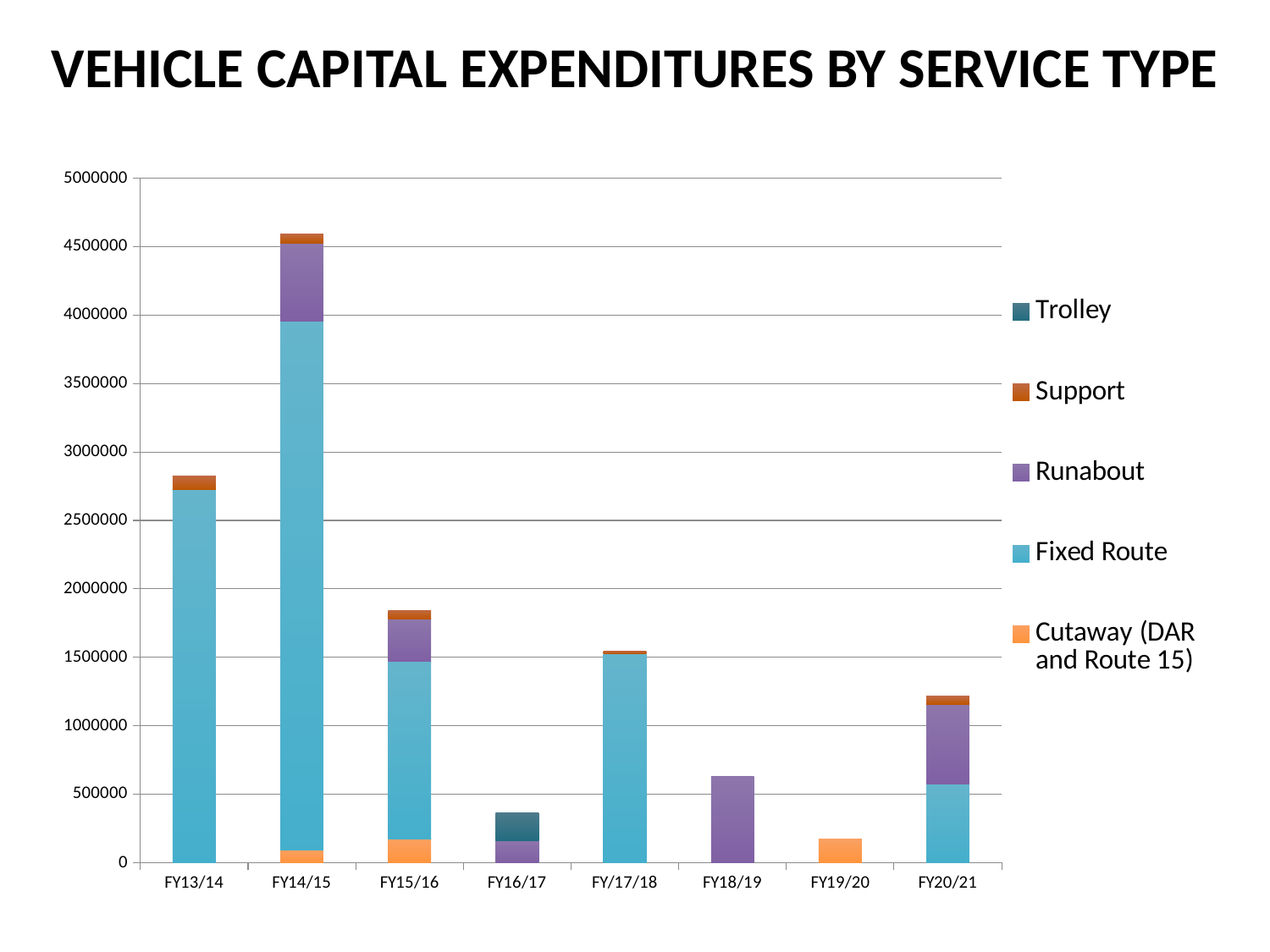
What kind of chart is shown on the slide? Stacked bar chart How many fiscal years are shown on the x axis? 8 Which fiscal year is the only one with a Trolley segment? FY16/17 Is the total value for FY20/21 greater or less than 1000000? greater Which has a larger total expenditure, FY16/17 or FY18/19? FY18/19 Is the total value for FY13/14 greater or less than 2500000? greater Which has a larger total expenditure, FY13/14 or FY15/16? FY13/14 How many series does the legend list? 5 Which fiscal year has the highest total vehicle capital expenditure? FY14/15 Is the total value for FY18/19 greater or less than 500000? greater Which fiscal year has the lowest total vehicle capital expenditure? FY19/20